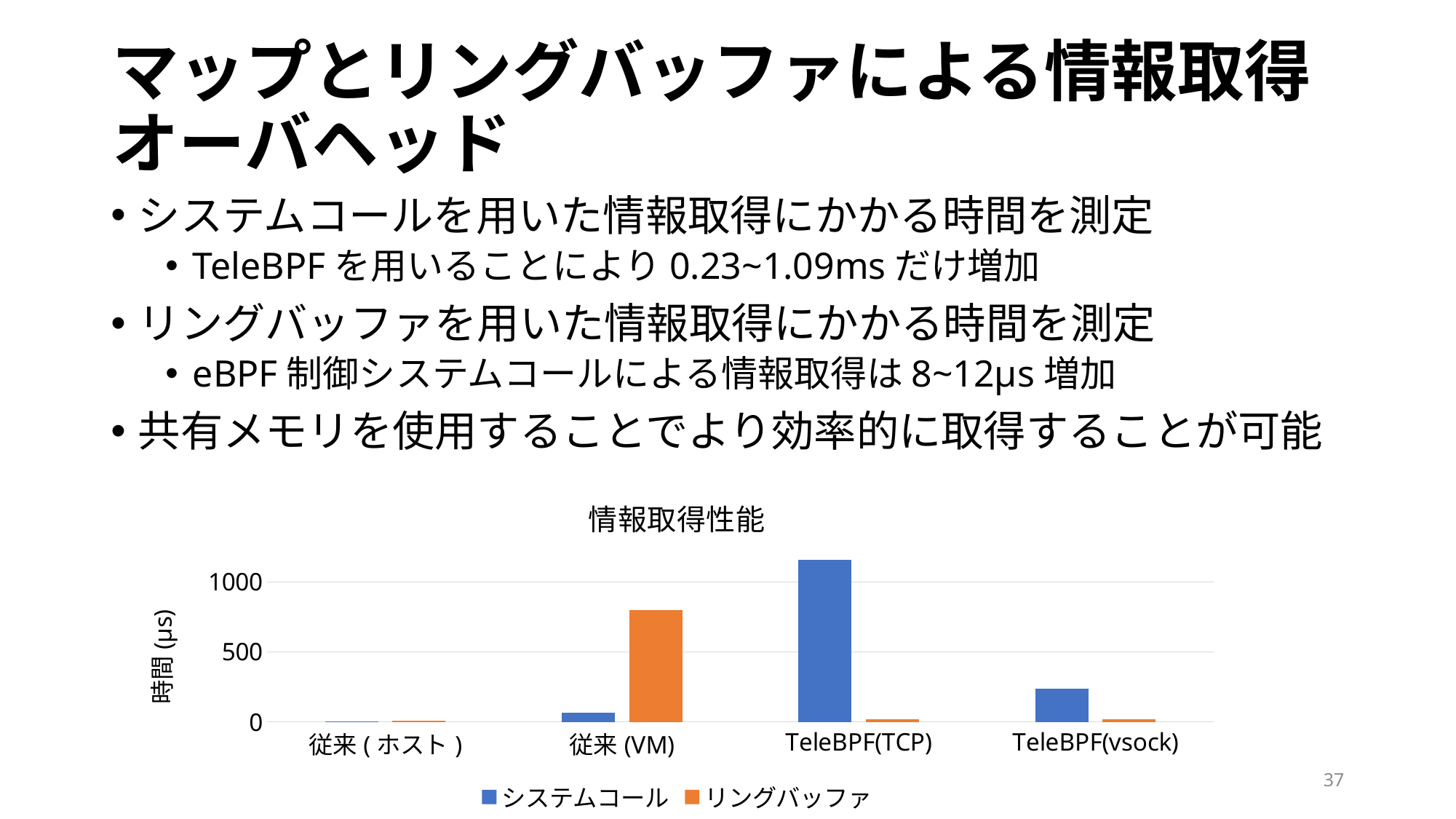
How many categories are shown on the x axis of the chart? 4 Is the リングバッファ value for 従来 (VM) greater or less than 500? greater Is the システムコール value for TeleBPF(TCP) greater or less than 1000? greater For 従来 (VM), which series has the larger value, システムコール or リングバッファ? リングバッファ What kind of chart is shown on the slide? bar chart Which category has the lowest value for the システムコール series? 従来 ( ホスト ) Which category has the highest value for the リングバッファ series? 従来 (VM) Which category has the highest value for the システムコール series? TeleBPF(TCP) What is the title of the chart? 情報取得性能 What is the label of the chart's y axis? 時間 (μs) How many series does the chart's legend list? 2 Is the システムコール value for TeleBPF(vsock) greater or less than 500? less